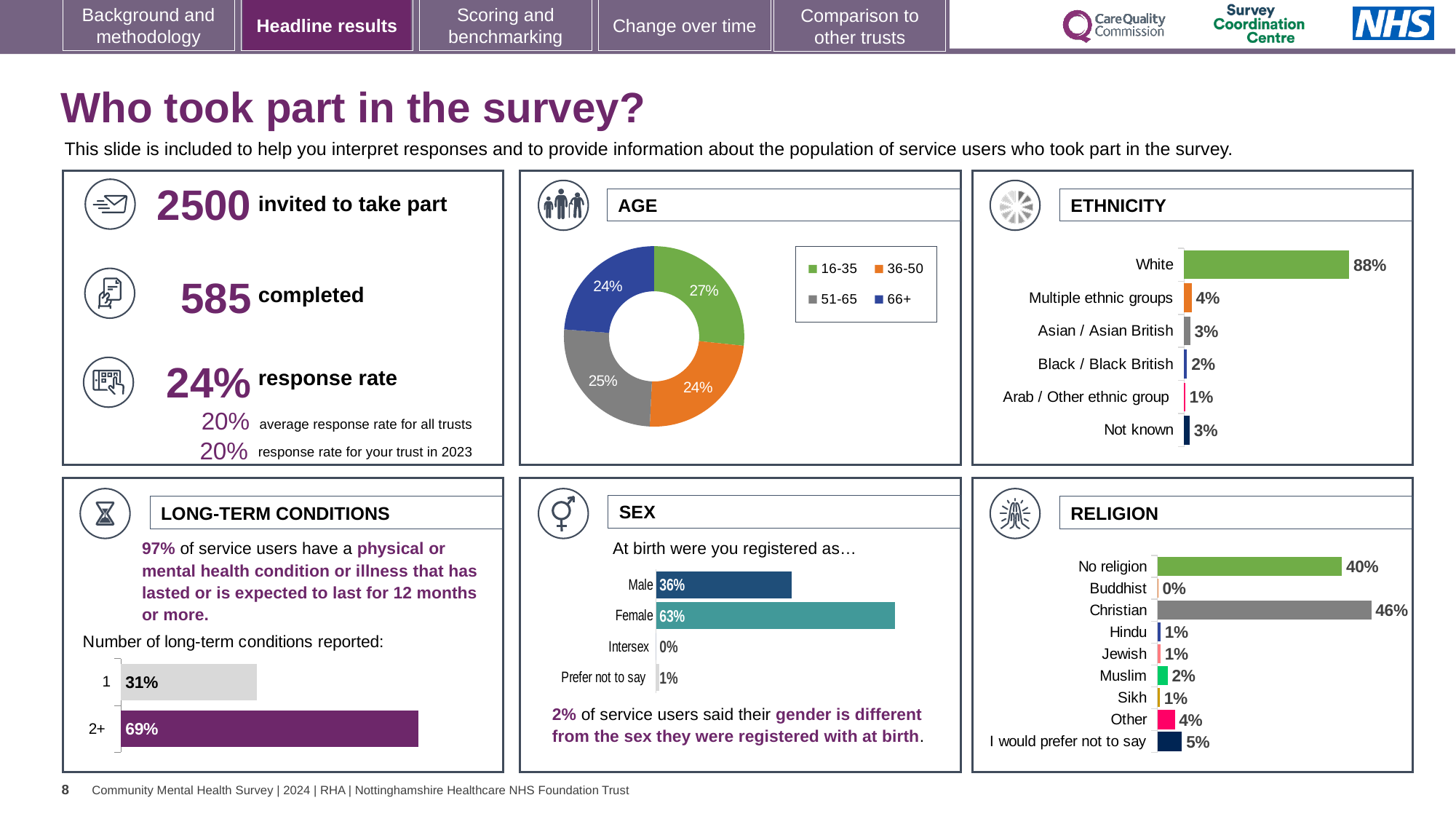
In the RELIGION chart, which is larger: No religion or Christian? Christian How many categories are shown in the ETHNICITY chart? 6 In the RELIGION chart, which category has the highest percentage? Christian In the ETHNICITY chart, what is the difference between the White and Asian / Asian British percentages? 85% How many age groups does the legend of the AGE chart list? 4 In the ETHNICITY chart, which ethnic group has the highest percentage? White In the LONG-TERM CONDITIONS chart, what is the difference between the percentages for 2+ and 1 conditions? 38% In the AGE chart, what percentage of respondents were aged 16-35? 27% In the SEX chart, what percentage of respondents were registered as Female at birth? 63% What kind of chart is the AGE chart? Doughnut chart In the RELIGION chart, what is the percentage for I would prefer not to say? 5% In the ETHNICITY chart, what is the percentage for Multiple ethnic groups? 4%